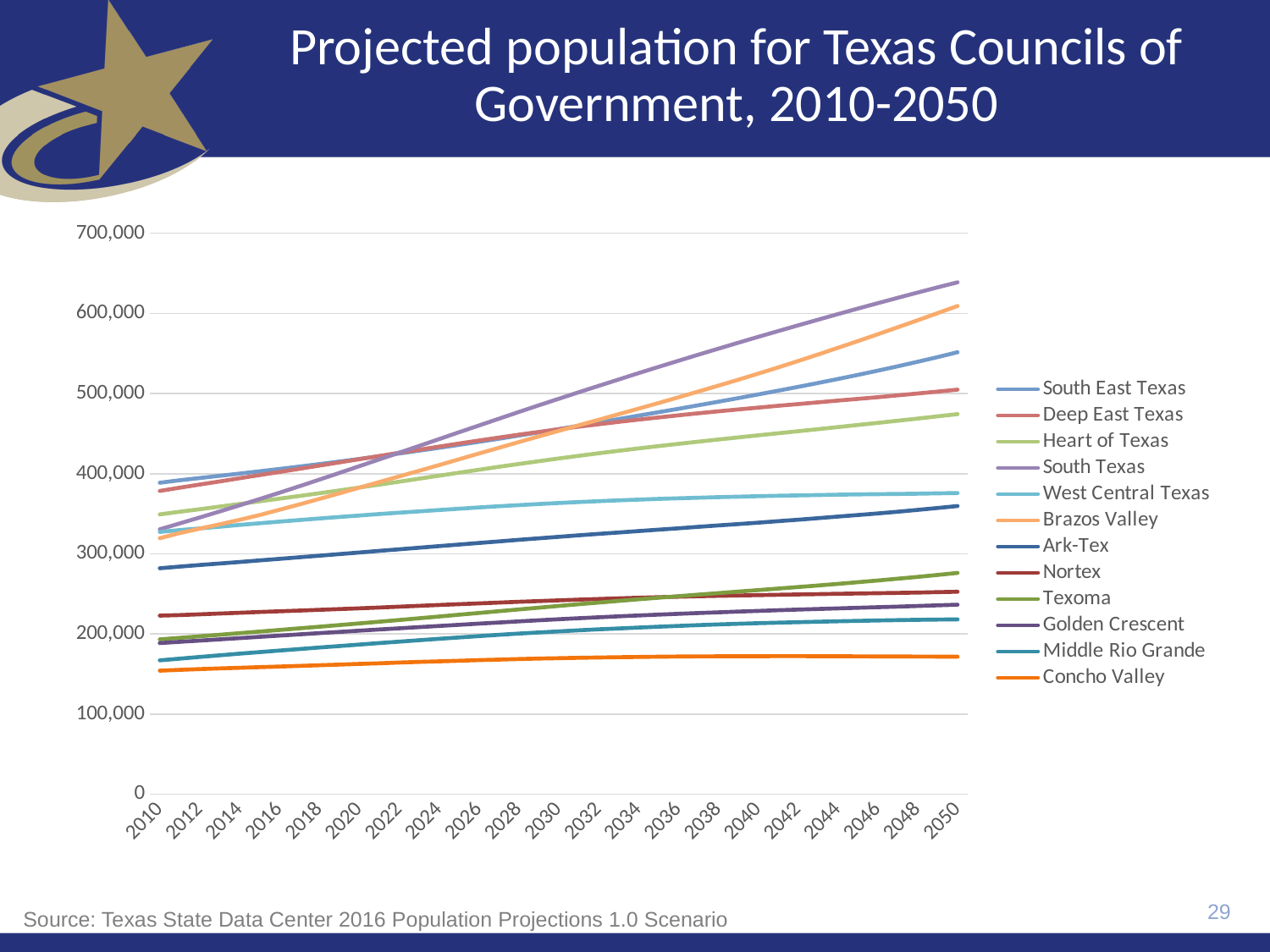
Which council of government has the lowest projected population in 2010? Concho Valley Which council of government has the highest projected population in 2050? South Texas Is the value for South East Texas in 2050 greater or less than 500,000? greater In 2050, which is larger: the value for Texoma or the value for Nortex? Texoma Is the value for South Texas in 2050 greater or less than 600,000? greater What kind of chart is shown on the slide? Line chart What is the title of the chart? Projected population for Texas Councils of Government, 2010-2050 Which council of government has the lowest projected population in 2050? Concho Valley Does the projected population for South Texas rise or fall from 2010 to 2050? rise Is the value for Ark-Tex in 2050 greater or less than 400,000? less How many series does the legend list? 12 How many year labels are shown along the x axis? 21